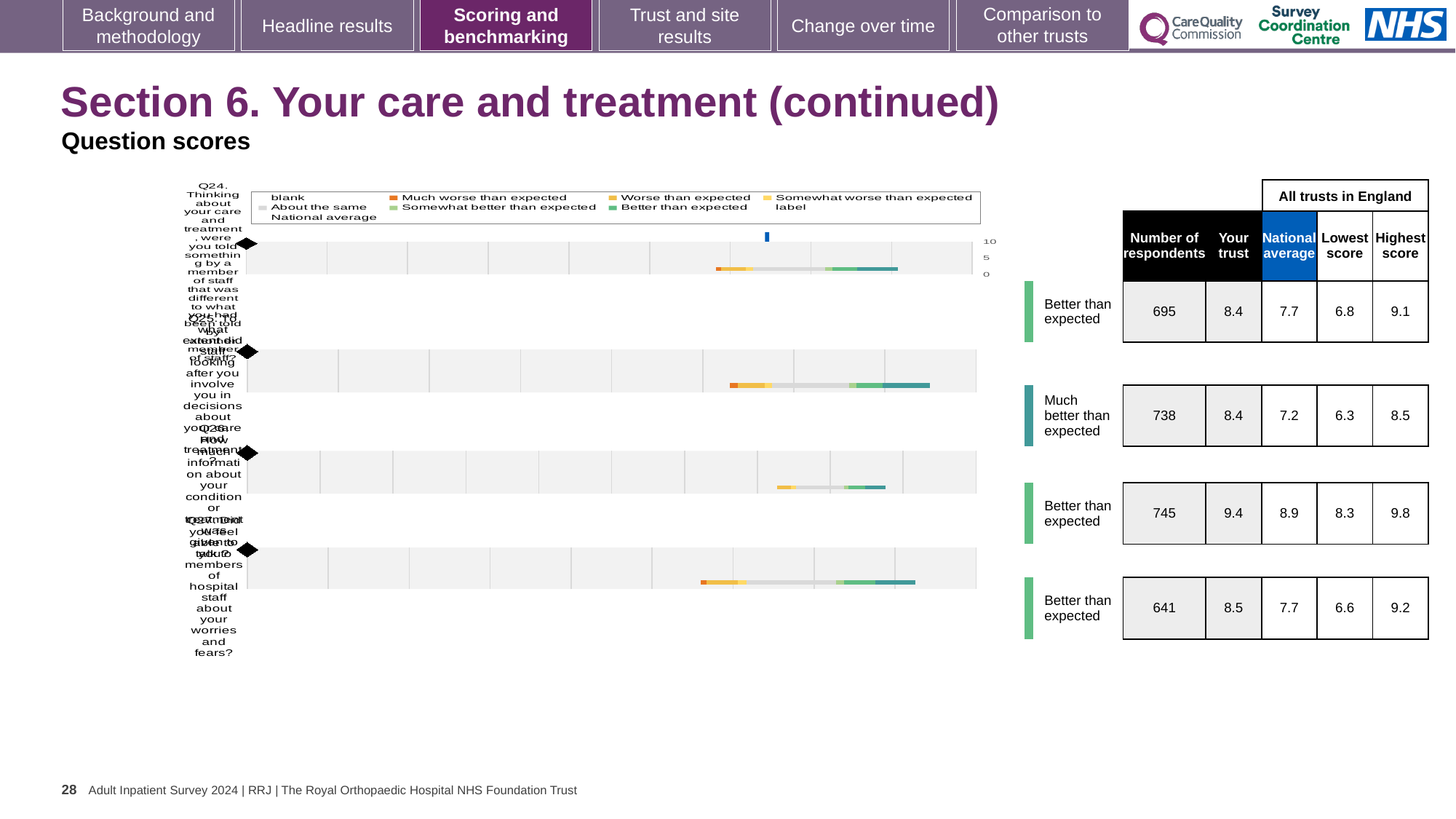
In the table beside the chart, what is the number of respondents for Q24? 695 What benchmark label is shown next to the Q25 bar? Much better than expected How many questions (bars) are plotted in the chart? 4 Which question has the lowest number of respondents in the table beside the chart? Q27 What is the difference between the 'Your trust' score and the national average for Q26? 0.5 In the table beside the chart, what is the lowest score for Q27? 6.6 In the table beside the chart, what is the 'Your trust' score for Q25? 8.4 For Q24, which is larger: the 'Your trust' score or the national average? Your trust What colour does the legend use for 'Much worse than expected'? orange In the table beside the chart, what is the national average for Q26? 8.9 What kind of chart is shown on the left of the slide? bar chart Which question has the highest 'Your trust' score in the table beside the chart? Q26